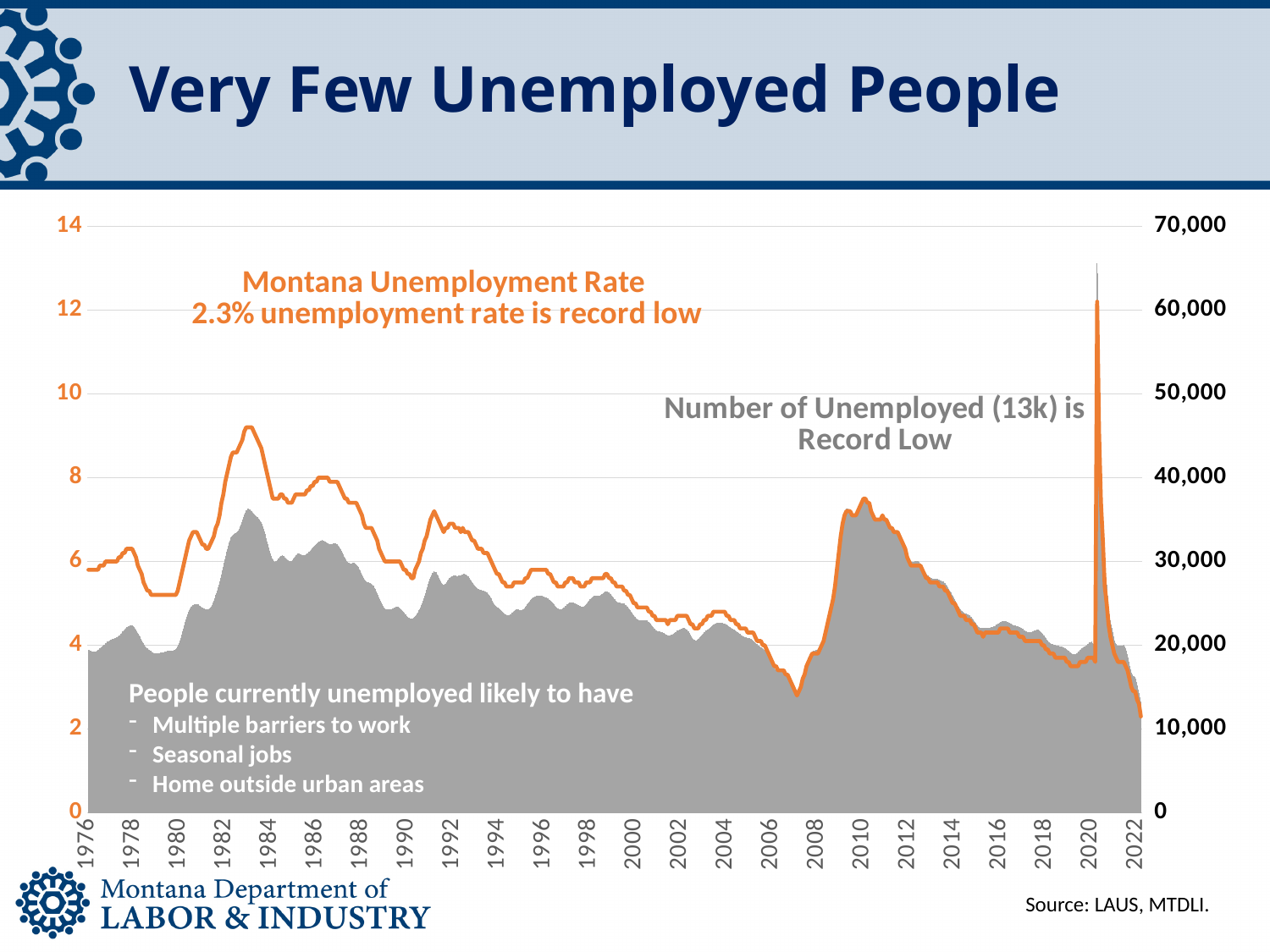
Which is higher, the Montana unemployment rate peak around 1983 or the peak around 2010? The peak around 1983 What is the highest value shown on the right-hand axis? 70,000 How many data series are plotted on the chart? 2 Is the number of unemployed at the 2020 spike greater or less than 50,000? greater Which series is drawn as the orange line? Montana Unemployment Rate According to the annotation on the chart, what is the record-low number of unemployed people? 13k How many year labels are shown on the x axis? 24 Overall, does the Montana unemployment rate rise or fall from 1976 to 2022? Fall Is the Montana unemployment rate around 2007 greater or less than 4? less What kind of chart is shown on the slide? A combined line and area chart According to the annotation on the chart, what is the record-low Montana unemployment rate? 2.3% Is the Montana unemployment rate around 1983 greater or less than 8? greater